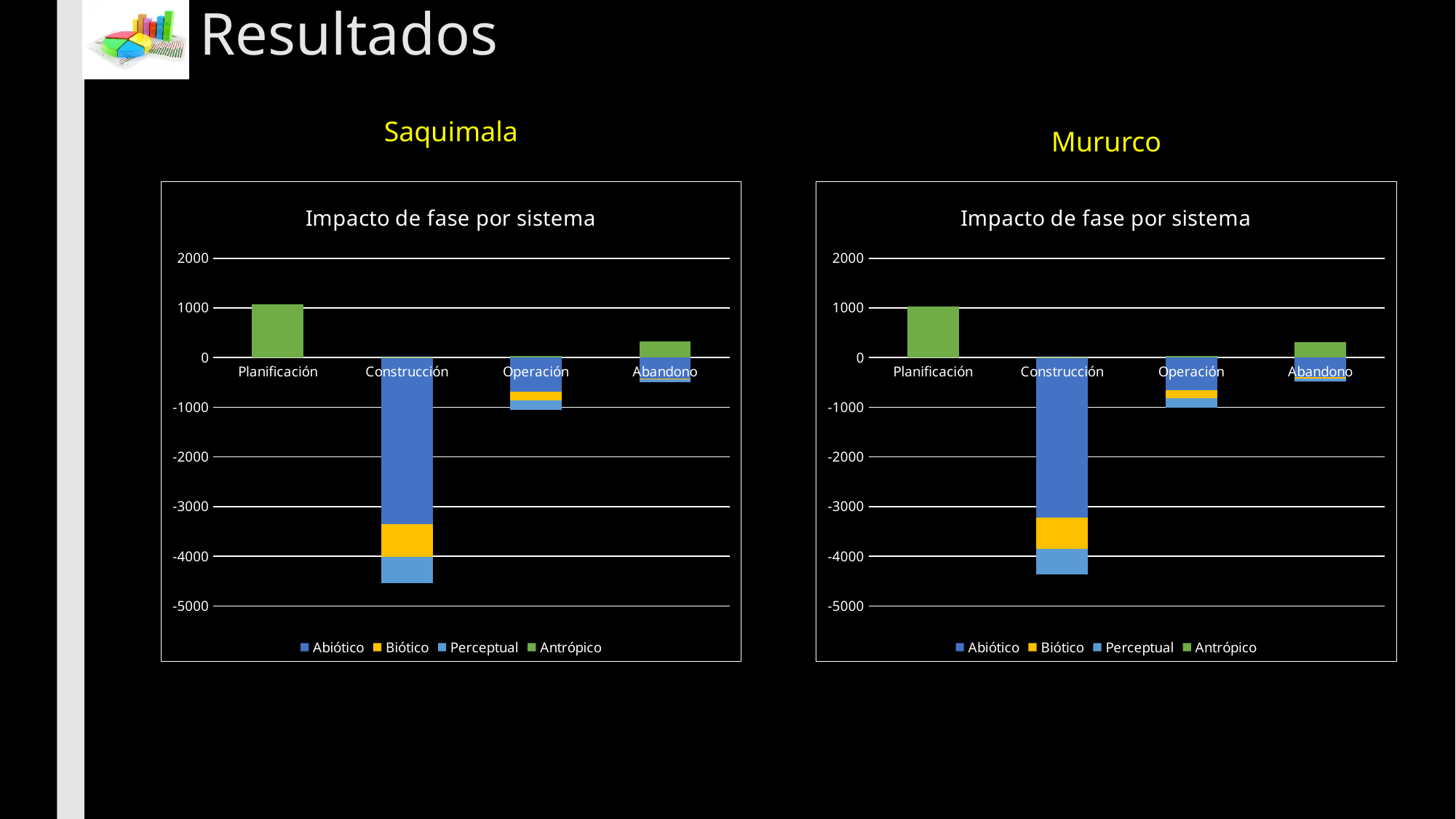
In the Saquimala chart, which is larger in magnitude: the Construcción stacked bar or the Operación stacked bar? Construcción In the Saquimala chart, which phase has the largest negative stacked total? Construcción In the Saquimala chart, is the Abiótico value for Construcción greater or less than -3000? less In the Saquimala chart, is the bottom of the Construcción stacked bar greater or less than -4000? less In the Mururco chart, is the Antrópico value for Abandono greater or less than 1000? less In the Saquimala chart, which colour represents the Biótico series? Yellow What is the title of the Mururco chart? Impacto de fase por sistema What type of chart is the Saquimala chart? Stacked bar chart How many phase categories are shown on the x axis of the Mururco chart? 4 How many series does the legend of the Saquimala chart list? 4 In the Mururco chart, which phase has the largest positive value? Planificación